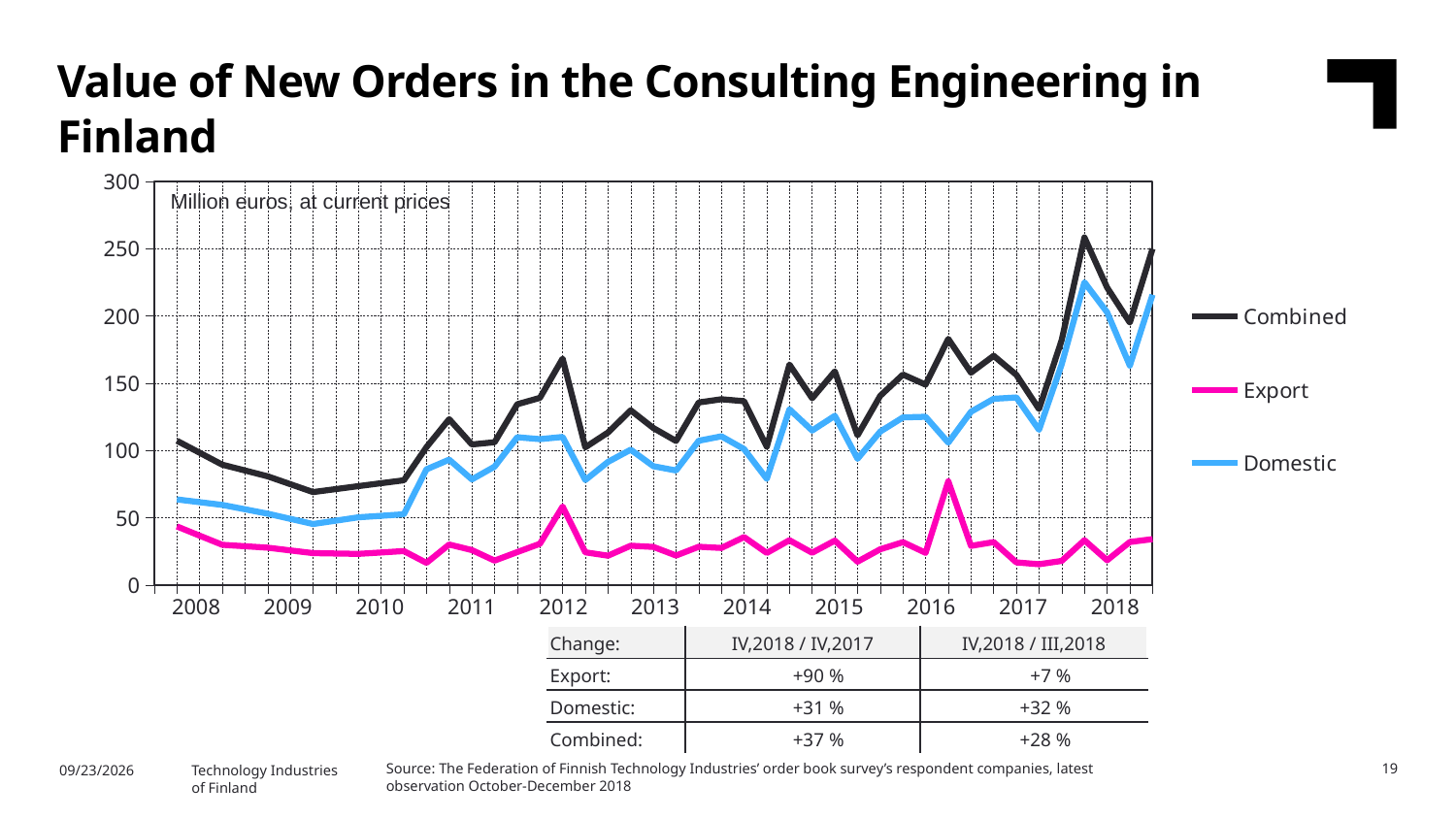
Is the Export value at the start of 2017 greater or less than 50? less Which series is plotted with the highest values throughout the chart? Combined How many series does the legend list? 3 How many years are labelled on the x axis? 11 What unit is stated in the chart area? Million euros, at current prices Does the Combined series generally rise or fall from 2009 to 2018? rise What kind of chart is shown on the slide? Line chart According to the table, what is the change in Export orders for IV,2018 / IV,2017? +90 % Is the lowest value of the Combined series in 2009 greater or less than 100? less Which series is plotted with the lowest values throughout the chart? Export Is the peak value of the Export series in 2016 greater or less than 50? greater